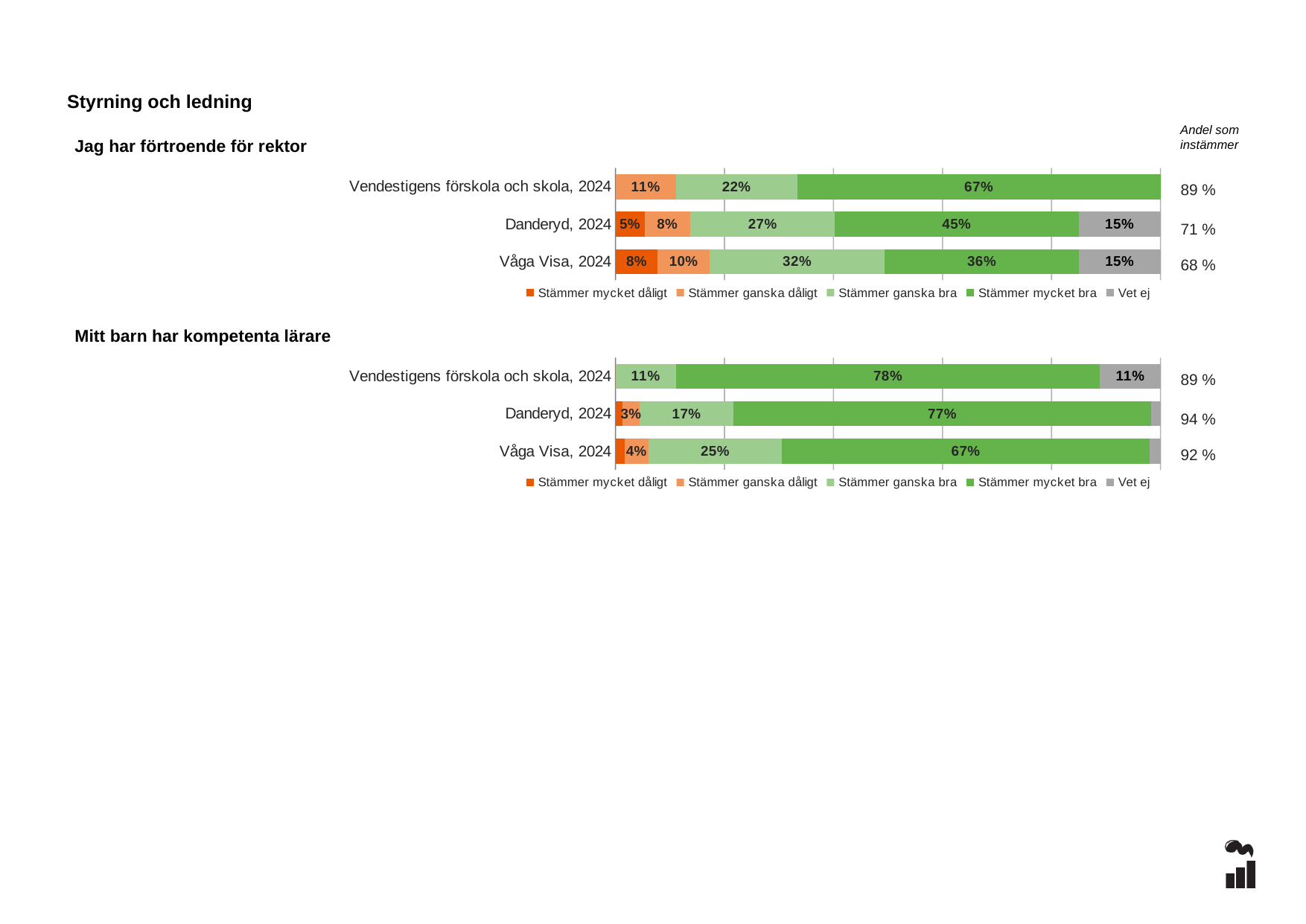
In the chart 'Mitt barn har kompetenta lärare', is the 'Stämmer mycket bra' value larger for Vendestigens förskola och skola, 2024 or for Våga Visa, 2024? Vendestigens förskola och skola, 2024 How many series does the legend of the chart 'Jag har förtroende för rektor' list? 5 In the chart 'Mitt barn har kompetenta lärare', which category has the lowest 'Stämmer mycket bra' value? Våga Visa, 2024 How many categories are shown in the chart 'Mitt barn har kompetenta lärare'? 3 What kind of chart is 'Jag har förtroende för rektor'? Stacked bar chart In the chart 'Jag har förtroende för rektor', what is the 'Stämmer ganska bra' value for Våga Visa, 2024? 32% In the chart 'Jag har förtroende för rektor', what is the difference between the 'Stämmer mycket bra' values for Danderyd, 2024 and Våga Visa, 2024? 9% In the chart 'Jag har förtroende för rektor', which category has the highest 'Stämmer mycket bra' value? Vendestigens förskola och skola, 2024 In the chart 'Mitt barn har kompetenta lärare', what is the 'Stämmer ganska bra' value for Våga Visa, 2024? 25% In the chart 'Jag har förtroende för rektor', what is the 'Stämmer mycket bra' value for Vendestigens förskola och skola, 2024? 67% In the chart 'Mitt barn har kompetenta lärare', what is the 'Stämmer mycket bra' value for Danderyd, 2024? 77% In the chart 'Jag har förtroende för rektor', what is the 'Vet ej' value for Danderyd, 2024? 15%